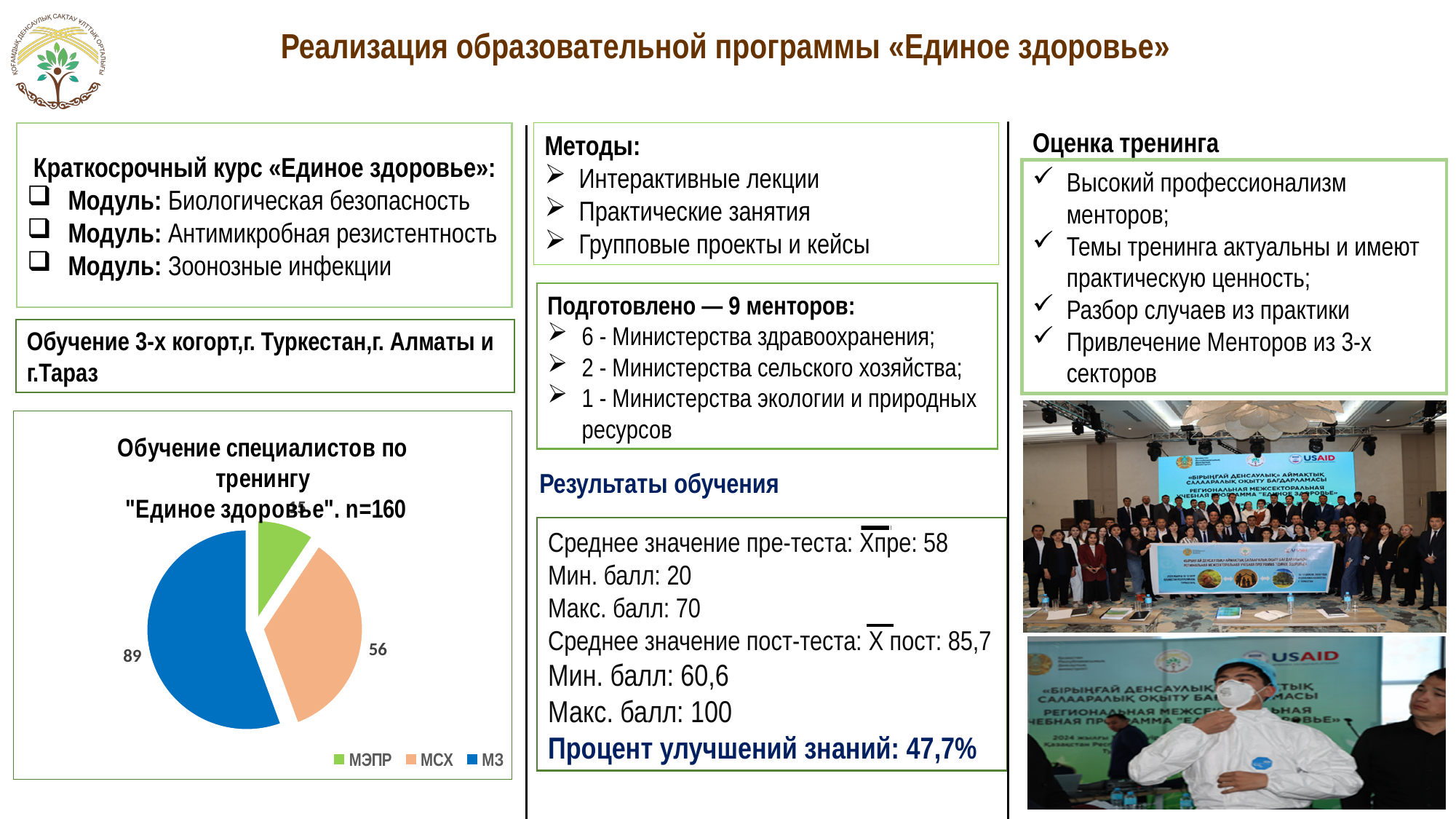
What sample size (n) is stated in the pie chart title? n=160 How many slices does the pie chart have? 3 Which is larger in the pie chart, МСХ or МЭПР? МСХ What is the difference between the values for МЗ and МСХ in the pie chart? 33 What is the value for МЗ in the pie chart? 89 Which is larger in the pie chart, МЗ or МСХ? МЗ What colour represents МЗ in the pie chart? blue Which category has the smallest slice in the pie chart? МЭПР How many entries does the legend of the pie chart list? 3 What is the value for МСХ in the pie chart? 56 Which category has the largest slice in the pie chart? МЗ What kind of chart is shown on the slide? pie chart